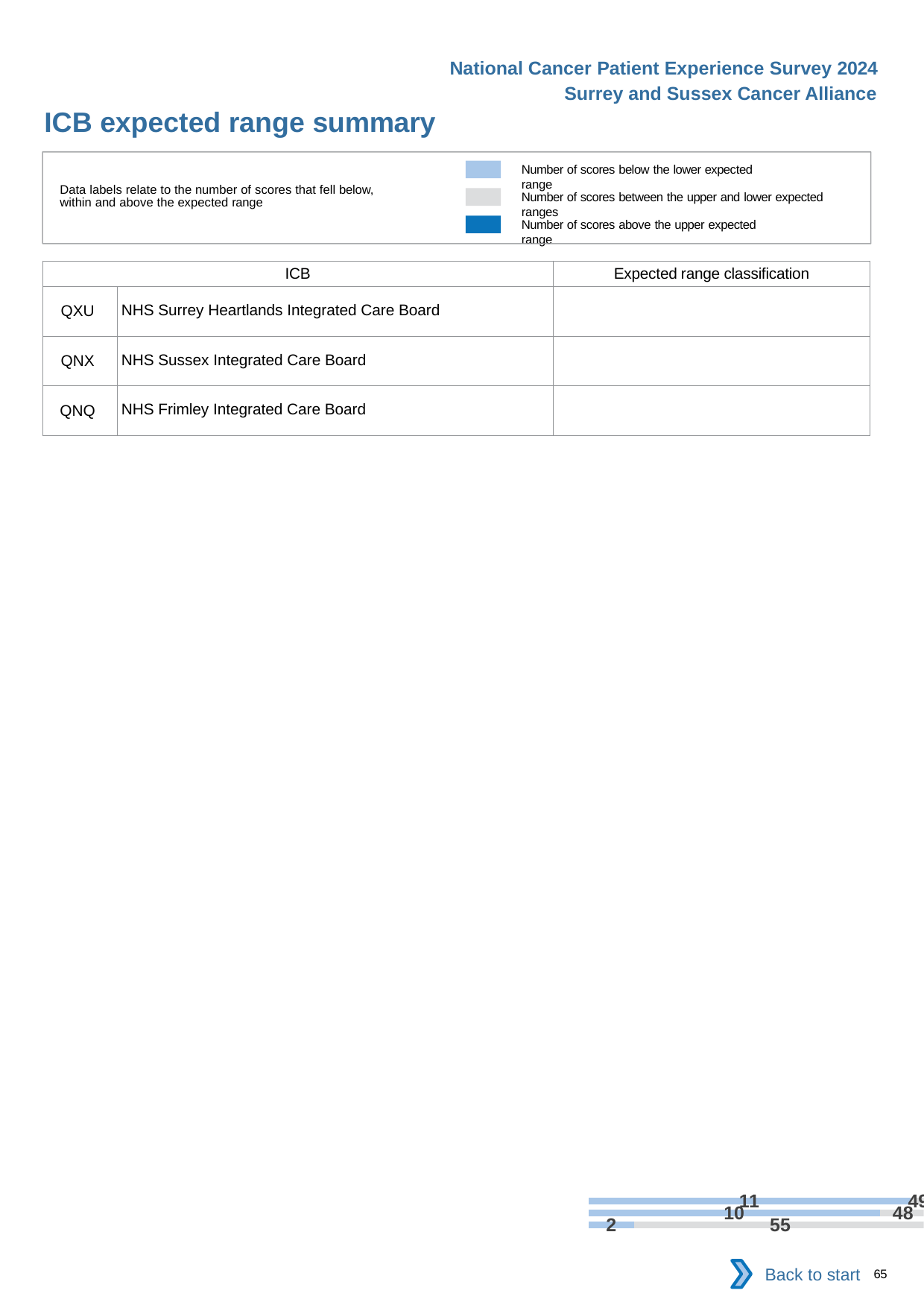
In the chart at the bottom right, what is the value of the light blue segment of the bottom bar? 2 How many bars are plotted in the chart at the bottom right of the slide? 3 In the chart at the bottom right, what is the total of the middle bar (10 and 48)? 58 In the chart at the bottom right, what is the value of the light blue segment of the middle bar? 10 According to the legend, which colour represents the number of scores above the upper expected range? dark blue In the chart at the bottom right, which segment of the bottom bar is larger, the light blue one or the grey one? the grey one In the chart at the bottom right, what is the total of the bottom bar (2 and 55)? 57 In the chart at the bottom right, what is the value of the grey segment of the bottom bar? 55 In the chart at the bottom right, what is the difference between the grey segment (55) and the light blue segment (2) of the bottom bar? 53 What kind of chart is shown at the bottom right of the slide? bar chart How many categories does the legend at the top of the slide list? 3 In the chart at the bottom right, what is the value of the grey segment of the middle bar? 48